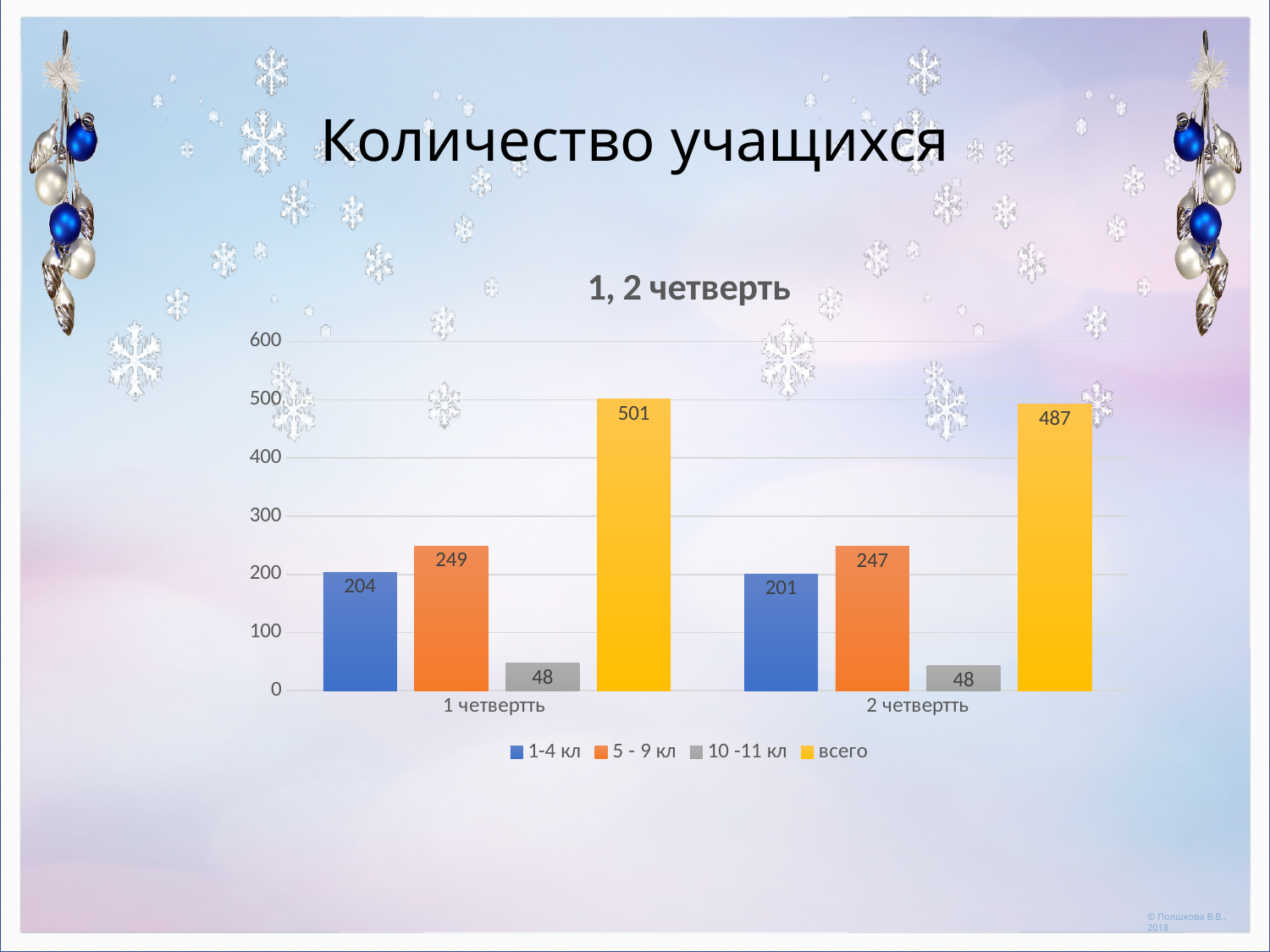
What is the title of the chart? 1, 2 четверть What is the value for 5 - 9 кл in 2 четвертть? 247 Which series has the highest value in 1 четвертть? всего How many categories are shown on the x axis? 2 What kind of chart is shown on the slide? bar chart Which series has the lowest value in 2 четвертть? 10 -11 кл What is the value for 10 -11 кл in 1 четвертть? 48 Which is larger: 5 - 9 кл in 1 четвертть or 5 - 9 кл in 2 четвертть? 5 - 9 кл in 1 четвертть How many series does the legend list? 4 What is the value for 1-4 кл in 1 четвертть? 204 What is the difference between the всего values for 1 четвертть and 2 четвертть? 14 What is the value for всего in 2 четвертть? 487